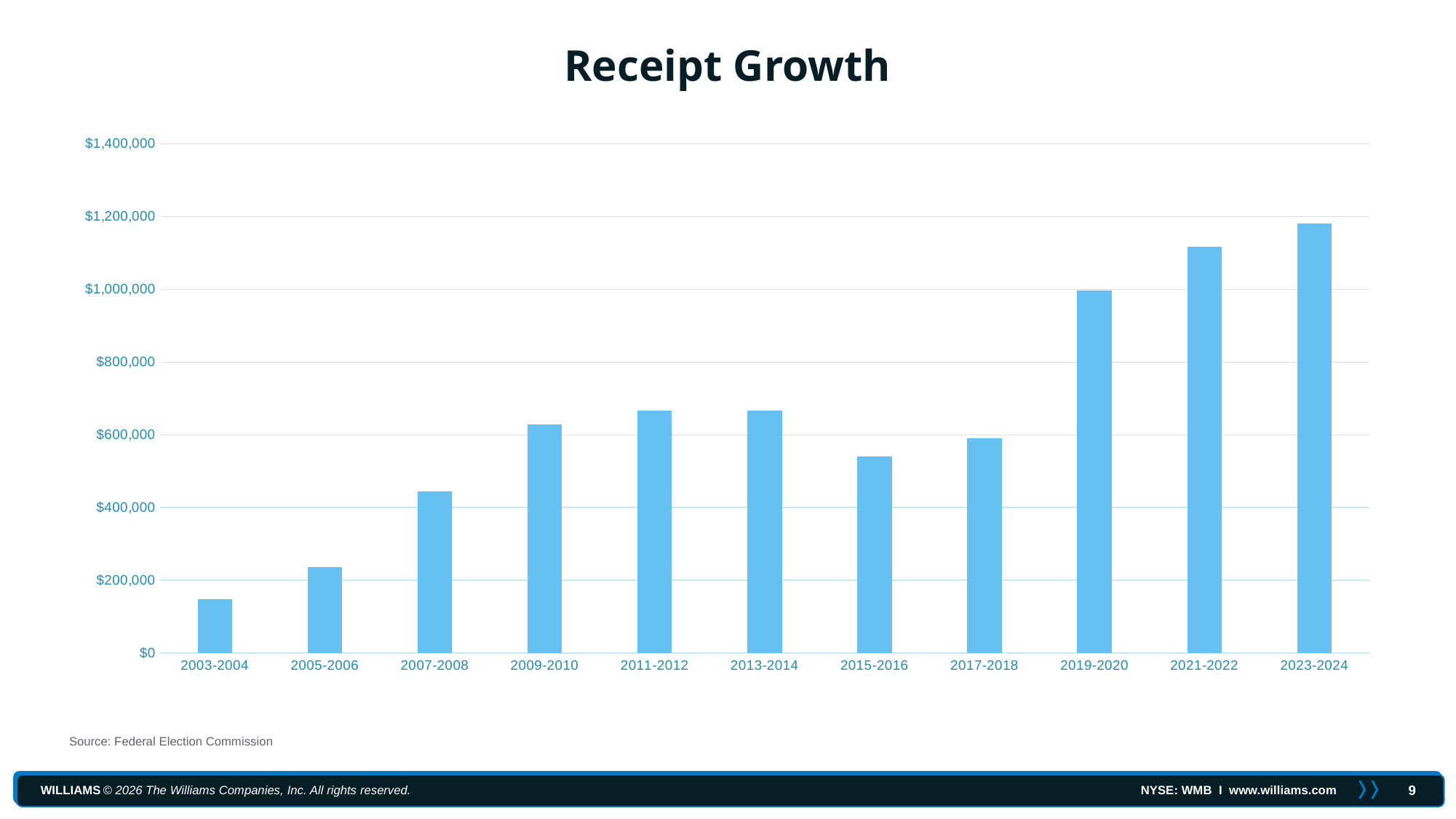
Which election cycle has the lowest receipts? 2003-2004 What source is cited for the chart data? Federal Election Commission Is the value for 2007-2008 greater or less than $400,000? greater Is the value for 2019-2020 greater or less than $800,000? greater Do receipts generally rise or fall from 2003-2004 to 2023-2024? rise Is the value for 2015-2016 greater or less than $600,000? less Which election cycle has the highest receipts? 2023-2024 How many election cycles (categories) are shown on the x axis? 11 Which is larger, the value for 2017-2018 or the value for 2015-2016? 2017-2018 What is the title of the chart? Receipt Growth What kind of chart is shown on the slide? bar chart